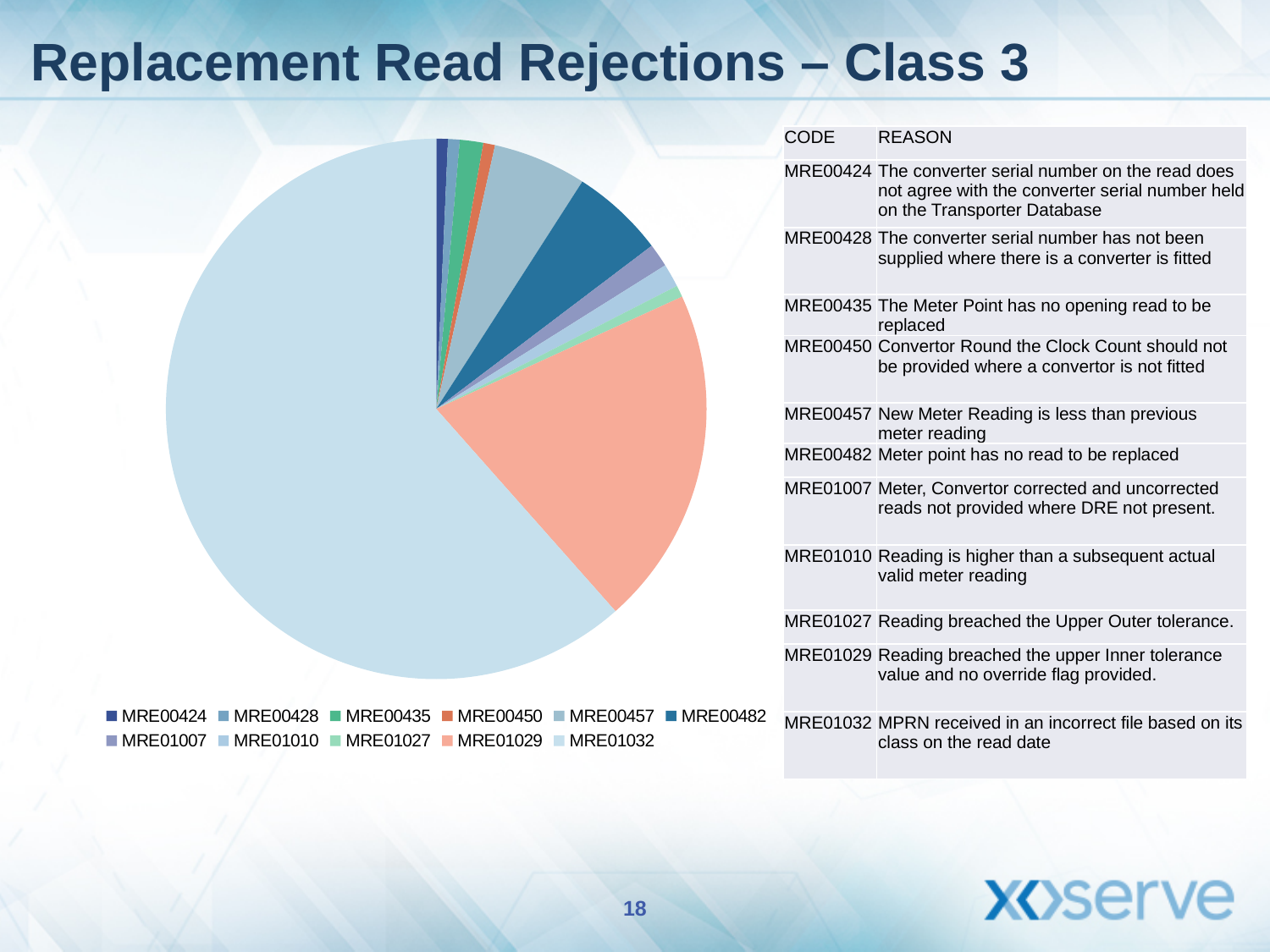
Which rejection code is listed first in the pie chart's legend? MRE00424 How many rejection codes are listed in the pie chart's legend? 11 Which rejection code has the largest slice of the pie chart? MRE01032 Which rejection code has the second largest slice of the pie chart? MRE01029 Which slice is larger in the pie chart, MRE01029 or MRE00482? MRE01029 Which rejection code is listed last in the pie chart's legend? MRE01032 What is the title of the slide containing the pie chart? Replacement Read Rejections – Class 3 What kind of chart is shown on the slide? pie chart Which slice is larger in the pie chart, MRE00482 or MRE01007? MRE00482 Does the MRE01032 slice account for more or less than half of the pie chart? more Which slice is larger in the pie chart, MRE01032 or MRE01029? MRE01032